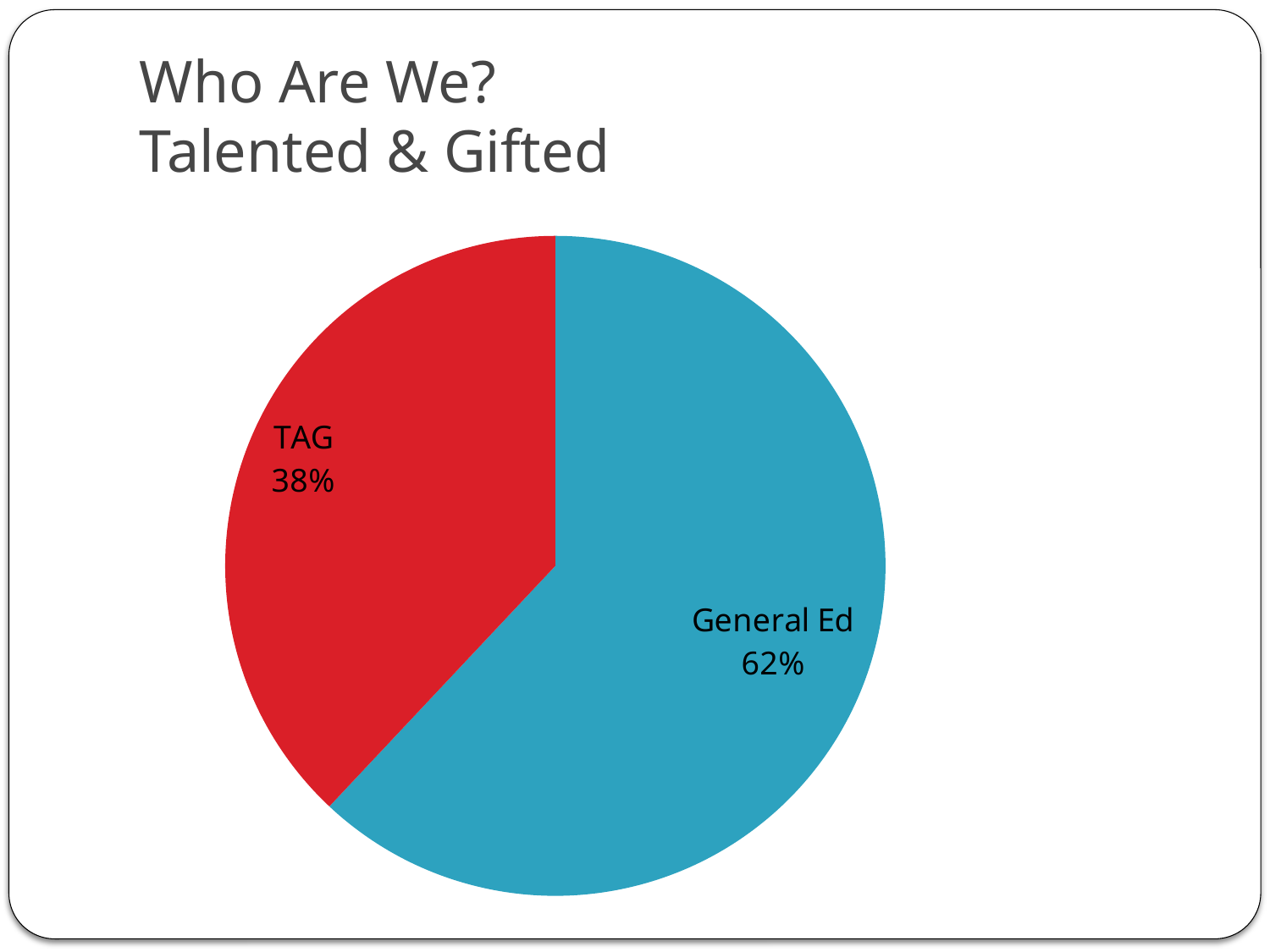
How many slices does the pie chart have? 2 What colour is the TAG slice? red Which slice is the largest? General Ed Which is larger, TAG or General Ed? General Ed Which slice is the smallest? TAG What share of the pie does General Ed represent? 62% What colour is the General Ed slice? blue What share of the pie does TAG represent? 38% Is the share for TAG greater or less than 50%? less What is the total of the two slices' percentages? 100% What kind of chart is shown on the slide? pie chart What is the difference in percentage points between General Ed and TAG? 24